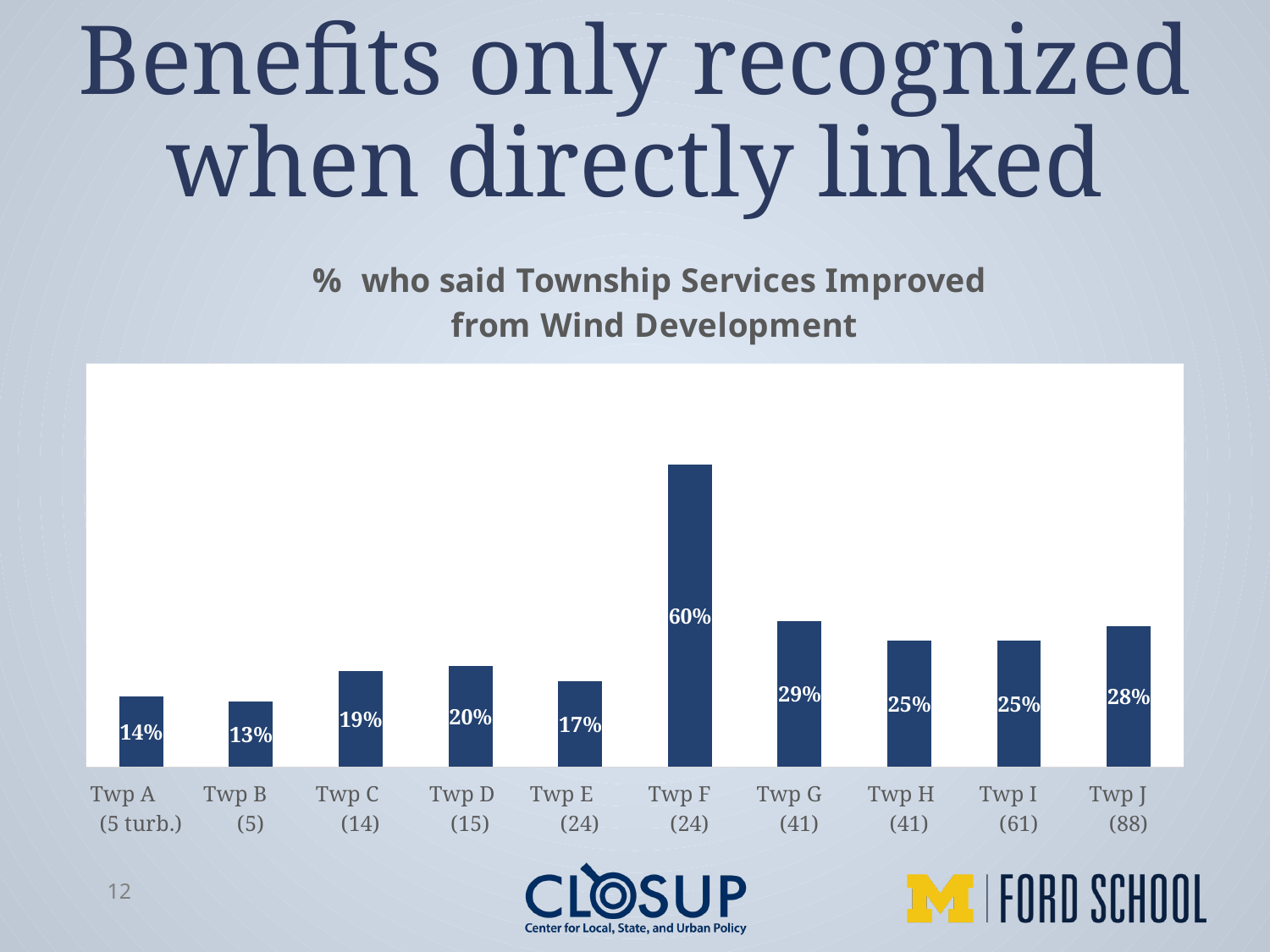
How many townships are shown on the chart? 10 What is the difference between the values for Twp F and Twp G? 31% Which two townships share the same value of 25%? Twp H and Twp I What percentage of respondents in Twp F said township services improved from wind development? 60% Which township has the lowest percentage saying services improved? Twp B What is the value shown for Twp J (88)? 28% What is the title of the chart? % who said Township Services Improved from Wind Development What type of chart is shown on the slide? Bar chart What is the value shown for Twp A (5 turb.)? 14% Which township has the highest percentage saying services improved? Twp F Which has a larger value, Twp C or Twp J? Twp J What is the difference between the values for Twp D and Twp E? 3%